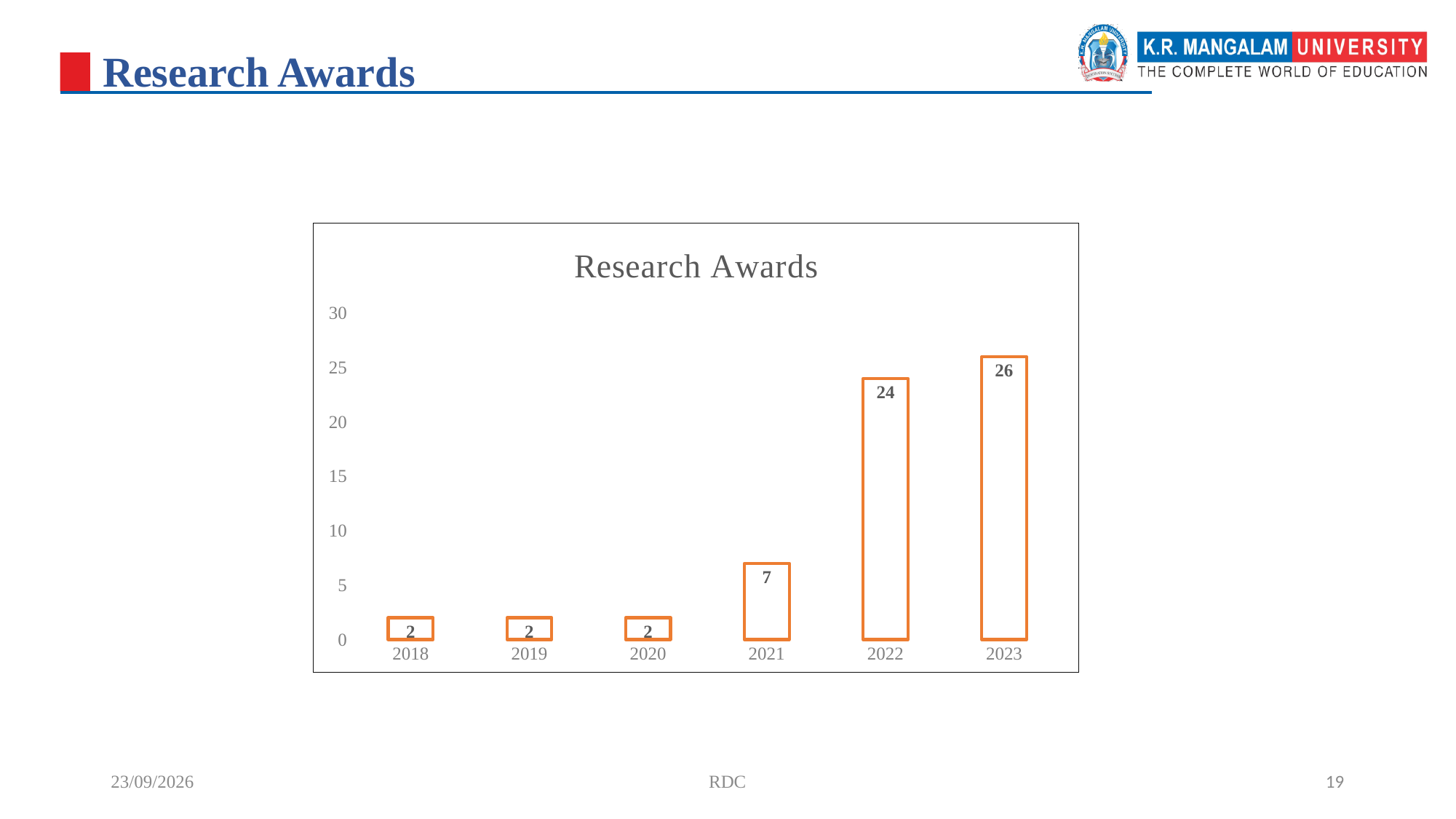
What is the difference between the values for 2022 and 2021? 17 What is the value for 2018 in the Research Awards chart? 2 What is the difference between the values for 2023 and 2022? 2 What is the title of the chart? Research Awards Which is larger, the value for 2021 or the value for 2020? 2021 Do the values generally rise or fall from 2018 to 2023? rise Which year has the highest value in the Research Awards chart? 2023 What kind of chart is shown on the slide? bar chart Is the value for 2022 greater or less than 20? greater What is the value for 2023 in the Research Awards chart? 26 What is the value for 2021 in the Research Awards chart? 7 How many years are shown on the x axis of the chart? 6